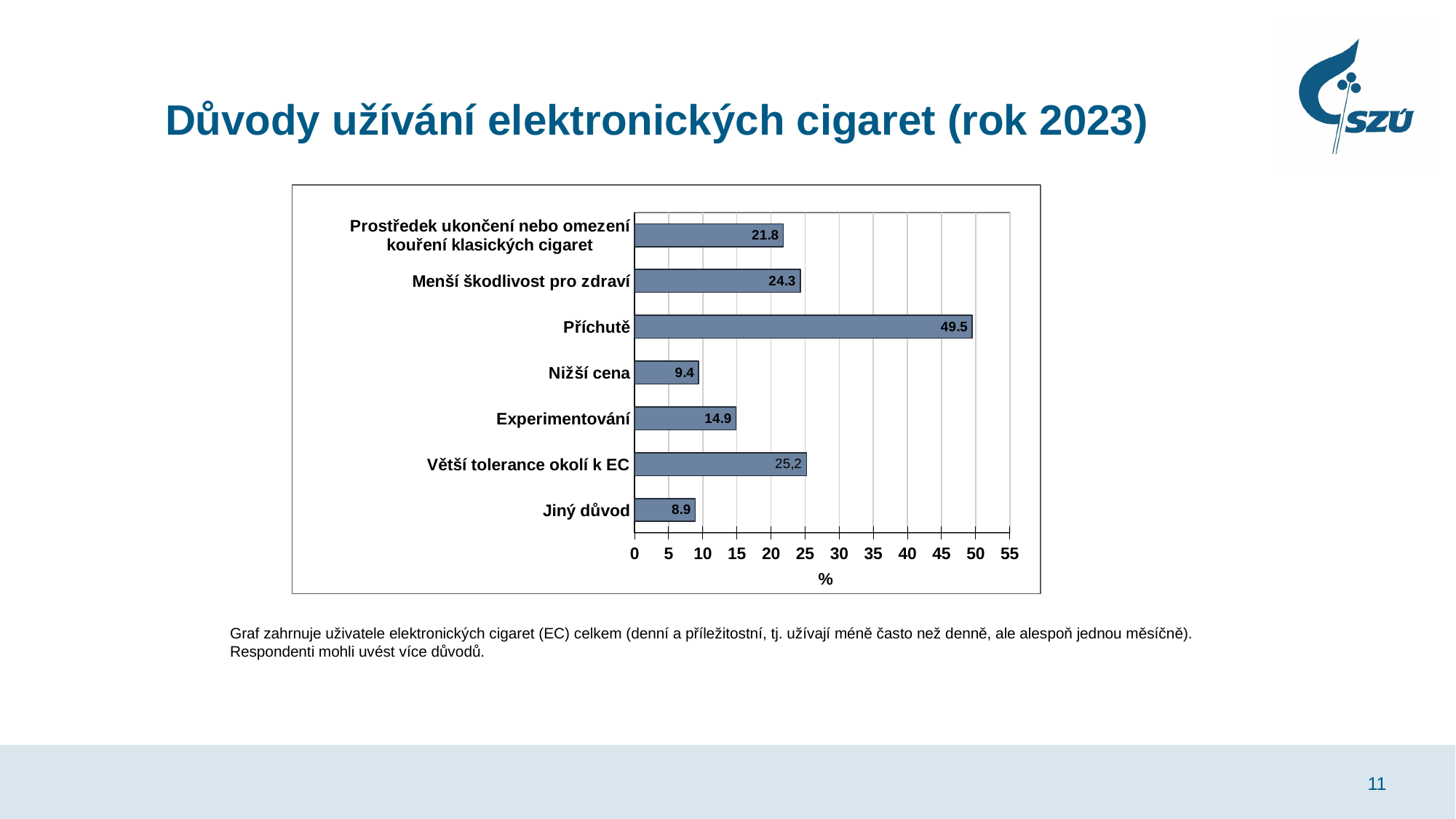
What unit is shown on the horizontal axis label? % What is the value for Větší tolerance okolí k EC? 25,2 What is the difference between the values for Příchutě and Menší škodlivost pro zdraví? 25.2 What is the value for Příchutě? 49.5 What kind of chart is shown on the slide? Bar chart What is the value for Prostředek ukončení nebo omezení kouření klasických cigaret? 21.8 Which category has the highest value? Příchutě Which is larger, the value for Menší škodlivost pro zdraví or the value for Experimentování? Menší škodlivost pro zdraví What is the value for Nižší cena? 9.4 Which category has the lowest value? Jiný důvod How many categories are shown in the chart? 7 What is the difference between the values for Experimentování and Jiný důvod? 6.0